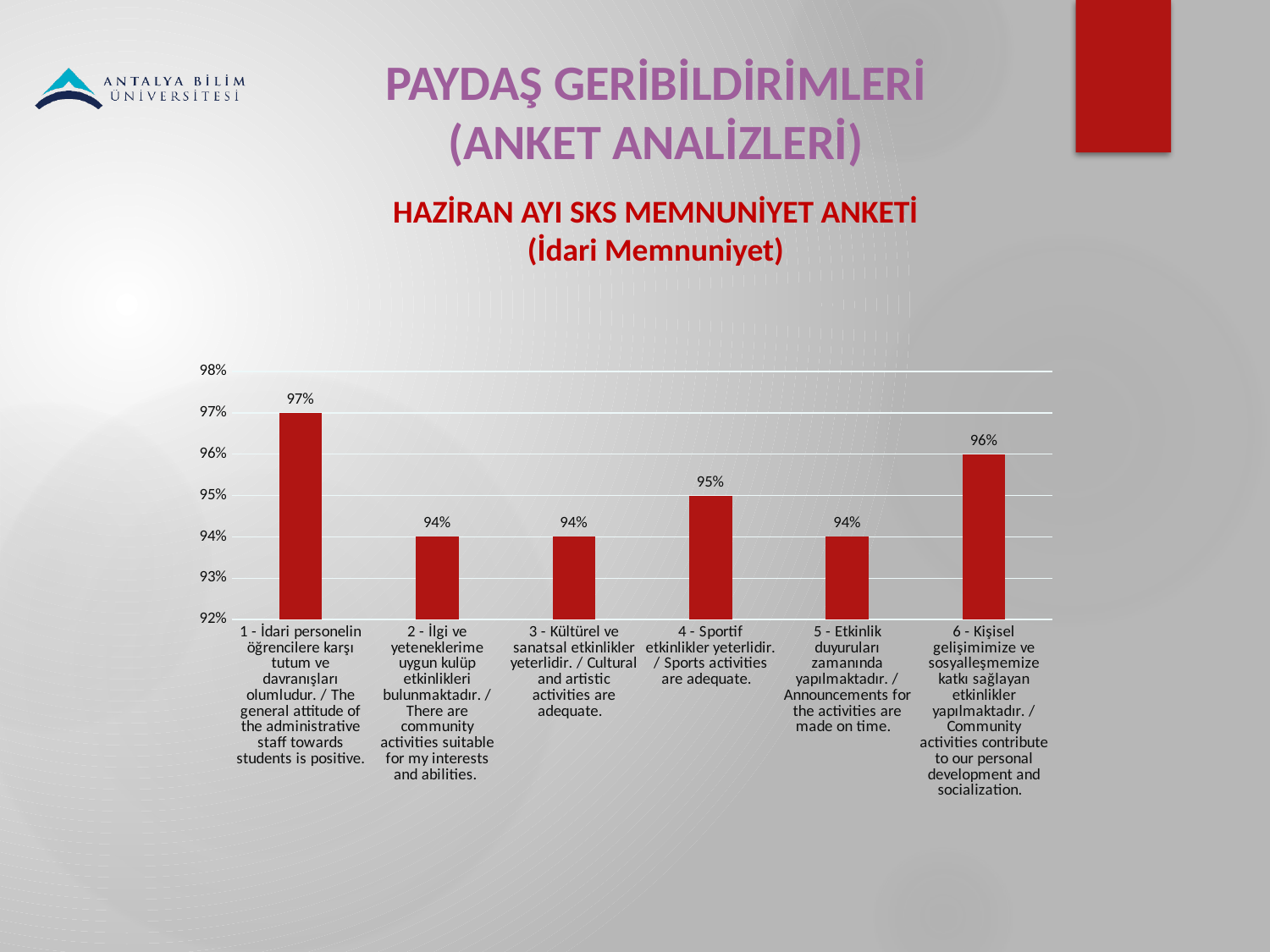
Which survey item has the highest value? 1 - İdari personelin öğrencilere karşı tutum ve davranışları olumludur Is the value for item 3 (Kültürel ve sanatsal etkinlikler yeterlidir) greater or less than 95%? less What is the value for item 4 (Sportif etkinlikler yeterlidir / Sports activities are adequate)? 95% What is the value for item 5 (Etkinlik duyuruları zamanında yapılmaktadır)? 94% What is the title of the chart on the slide? HAZİRAN AYI SKS MEMNUNİYET ANKETİ (İdari Memnuniyet) Which is larger, the value for item 4 or the value for item 6? item 6 What is the difference between the value for item 1 and the value for item 2? 3% How many categories (survey items) are plotted in the chart? 6 What kind of chart is shown on the slide? bar chart What is the difference between the value for item 6 and the value for item 4? 1% What is the value for item 6 (Kişisel gelişimimize ve sosyalleşmemize katkı sağlayan etkinlikler yapılmaktadır)? 96% What is the value for item 1 (İdari personelin öğrencilere karşı tutum ve davranışları olumludur)? 97%